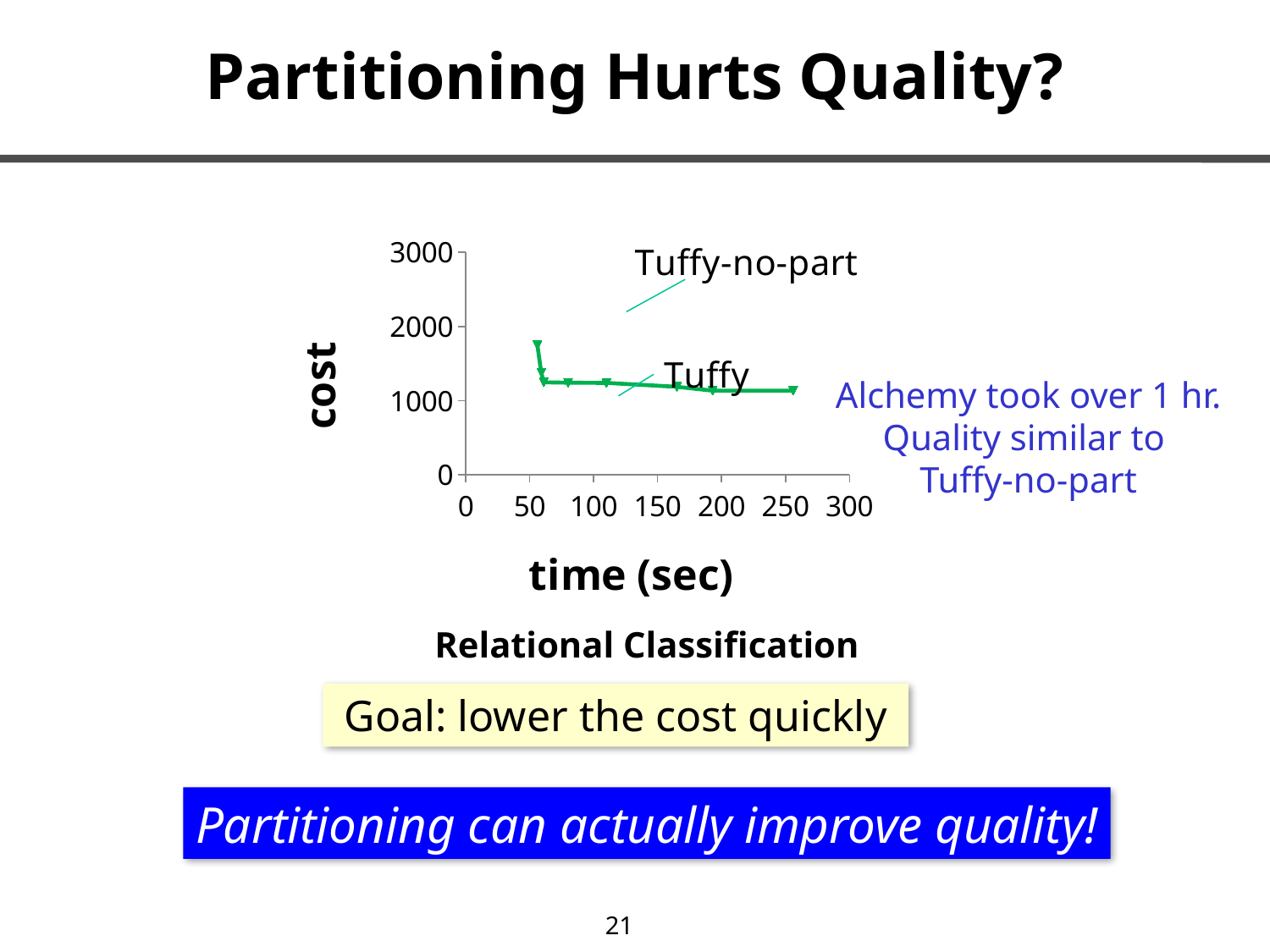
What is the title printed beneath the chart? Relational Classification Is the cost at the end of the Tuffy line (around 250 sec) greater or less than 2000? less Is the highest cost value plotted on the chart greater or less than 2000? less What is the label of the y axis? cost What is the maximum value shown on the y axis? 3000 Is the highest cost value plotted on the chart greater or less than 1000? greater What kind of chart is shown on the slide? line chart How many series are labelled on the chart? 2 Does the cost rise or fall as time increases along the x axis? fall